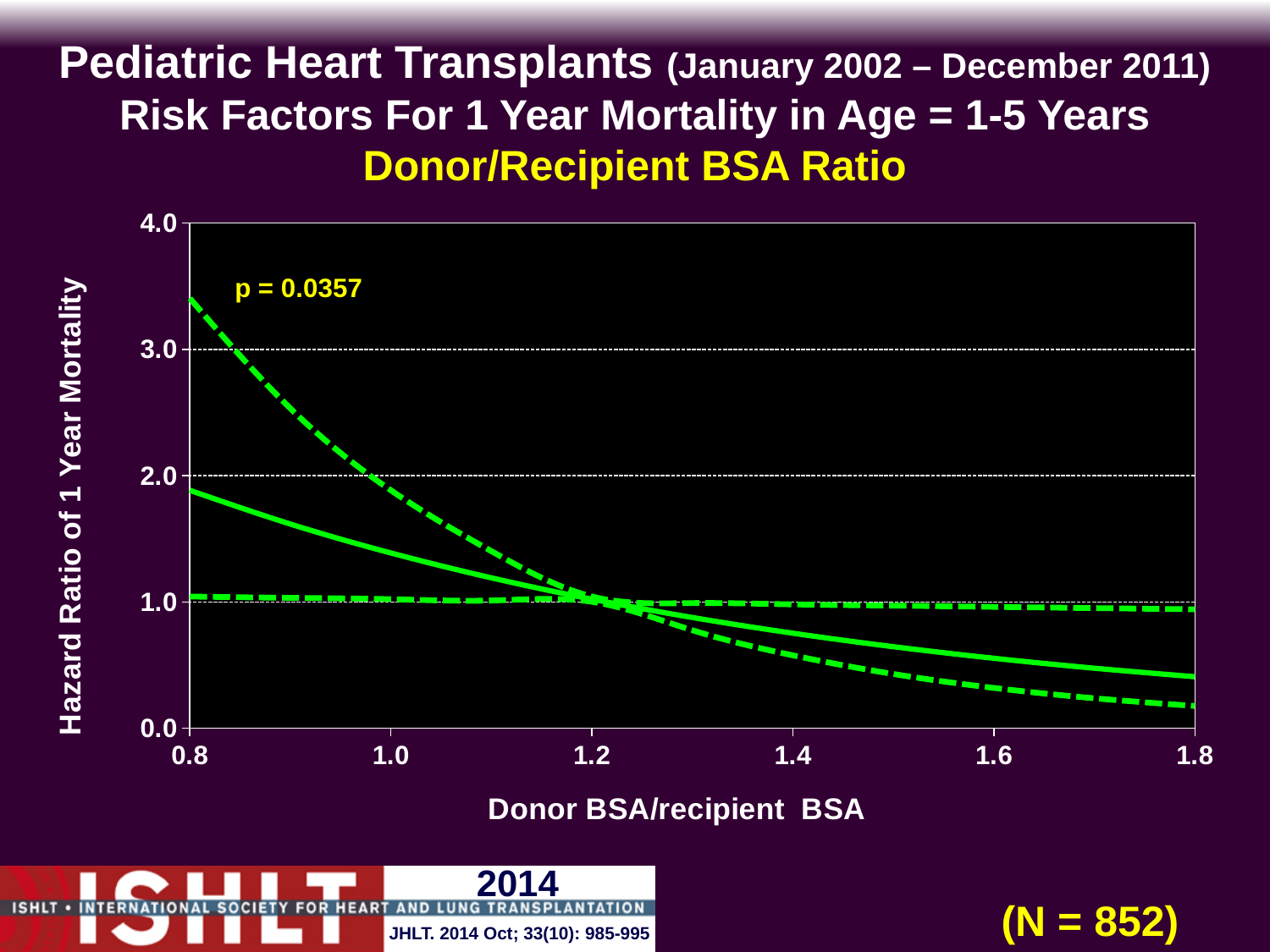
Is the value of the upper dashed line at a donor BSA/recipient BSA ratio of 0.8 greater or less than 3.0? greater Is the value of the lower dashed line at a donor BSA/recipient BSA ratio of 1.8 greater or less than 1.0? less What is the label of the y axis? Hazard Ratio of 1 Year Mortality What kind of chart is shown on the slide? line chart Is the value of the solid line at a donor BSA/recipient BSA ratio of 0.8 greater or less than 2.0? less What p-value is printed on the chart? p = 0.0357 Does the solid line rise or fall as the donor BSA/recipient BSA ratio increases from 0.8 to 1.8? fall How many lines are plotted on the chart? 3